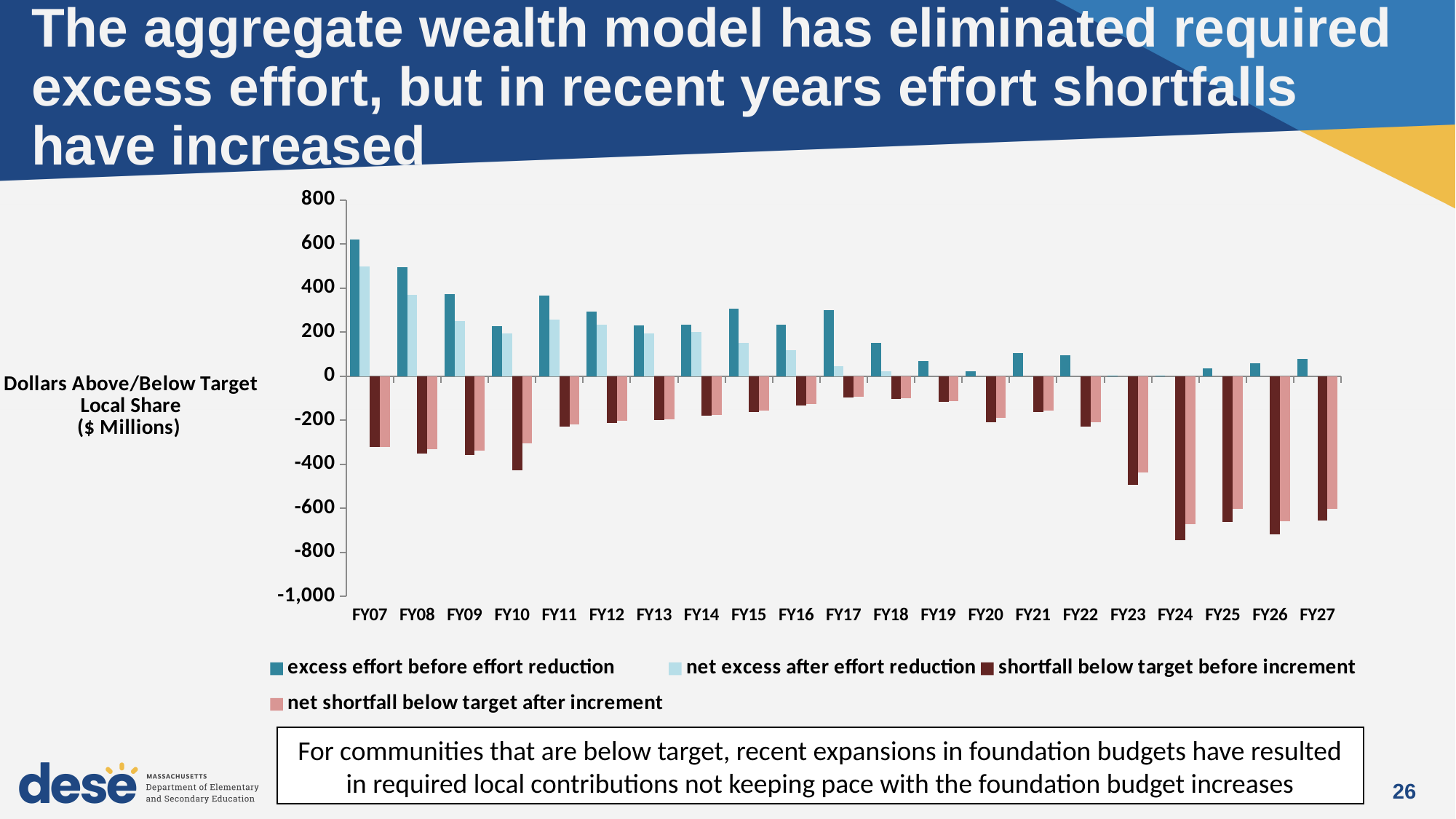
What kind of chart is shown on the slide? Bar chart How many fiscal years are shown on the x axis of the chart? 21 Which fiscal year has the lowest (most negative) value for shortfall below target before increment? FY24 Does the net excess after effort reduction generally rise or fall from FY07 to FY18? Fall Which fiscal year has a larger value for excess effort before effort reduction, FY10 or FY11? FY11 Is the value for shortfall below target before increment in FY10 greater or less than -400? less How many series does the chart's legend list? 4 Which fiscal year has the highest value for excess effort before effort reduction? FY07 Which fiscal year shows a larger shortfall below target before increment, FY23 or FY24? FY24 Is the value for net excess after effort reduction in FY17 greater or less than 200? less What is the label on the vertical axis of the chart? Dollars Above/Below Target Local Share ($ Millions) Is the value for excess effort before effort reduction in FY07 greater or less than 400? greater